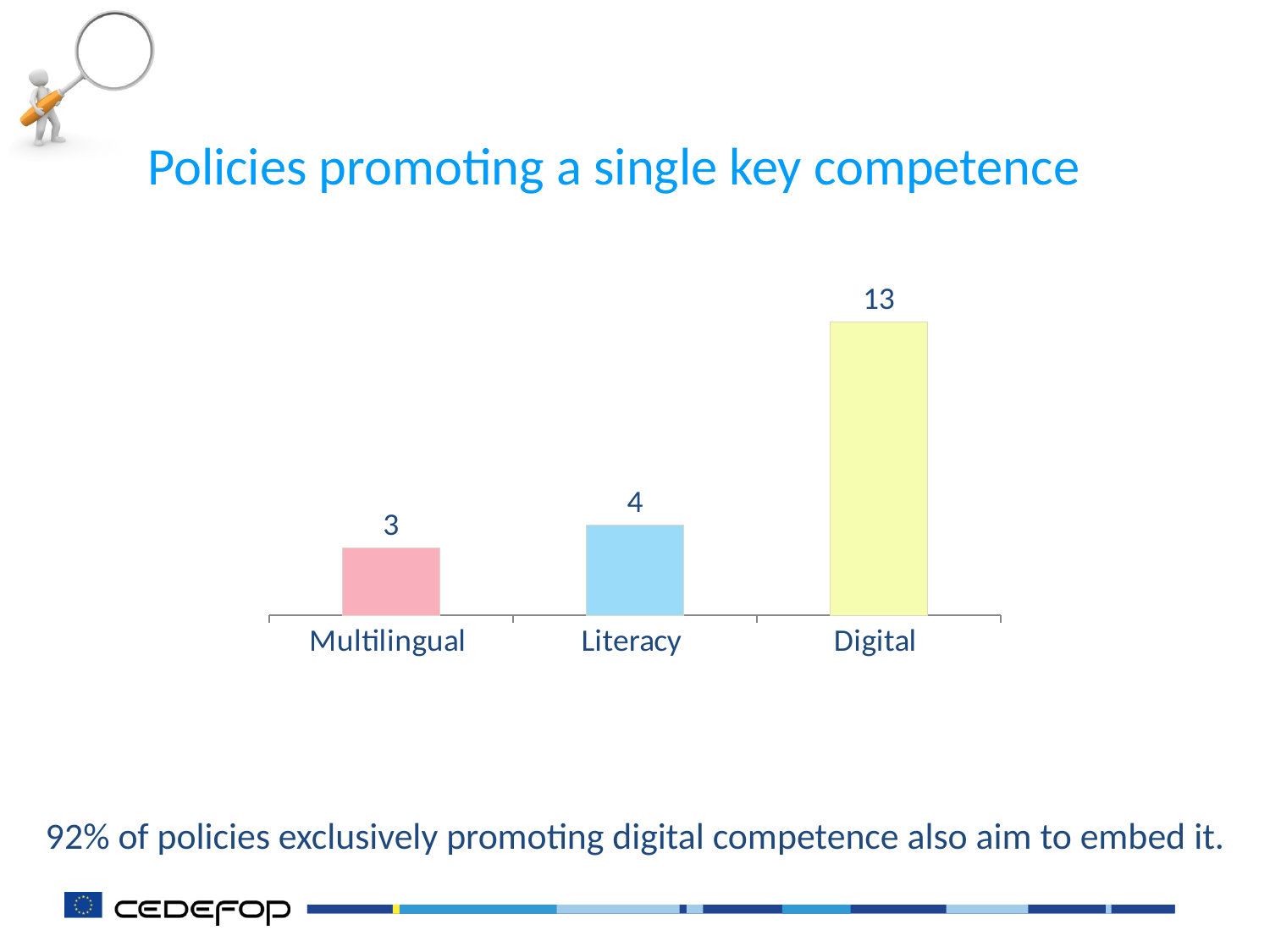
What is the difference between the values for Digital and Literacy? 9 What is the value for Literacy? 4 What is the value for Digital? 13 How many categories are shown in the chart? 3 What kind of chart is shown on the slide? Bar chart Which category has the highest value? Digital Which is larger, the value for Digital or the value for Multilingual? Digital What is the title of the slide containing the chart? Policies promoting a single key competence Do the values rise or fall from left to right across the categories? Rise What is the difference between the values for Literacy and Multilingual? 1 Which category has the lowest value? Multilingual What is the value for Multilingual? 3